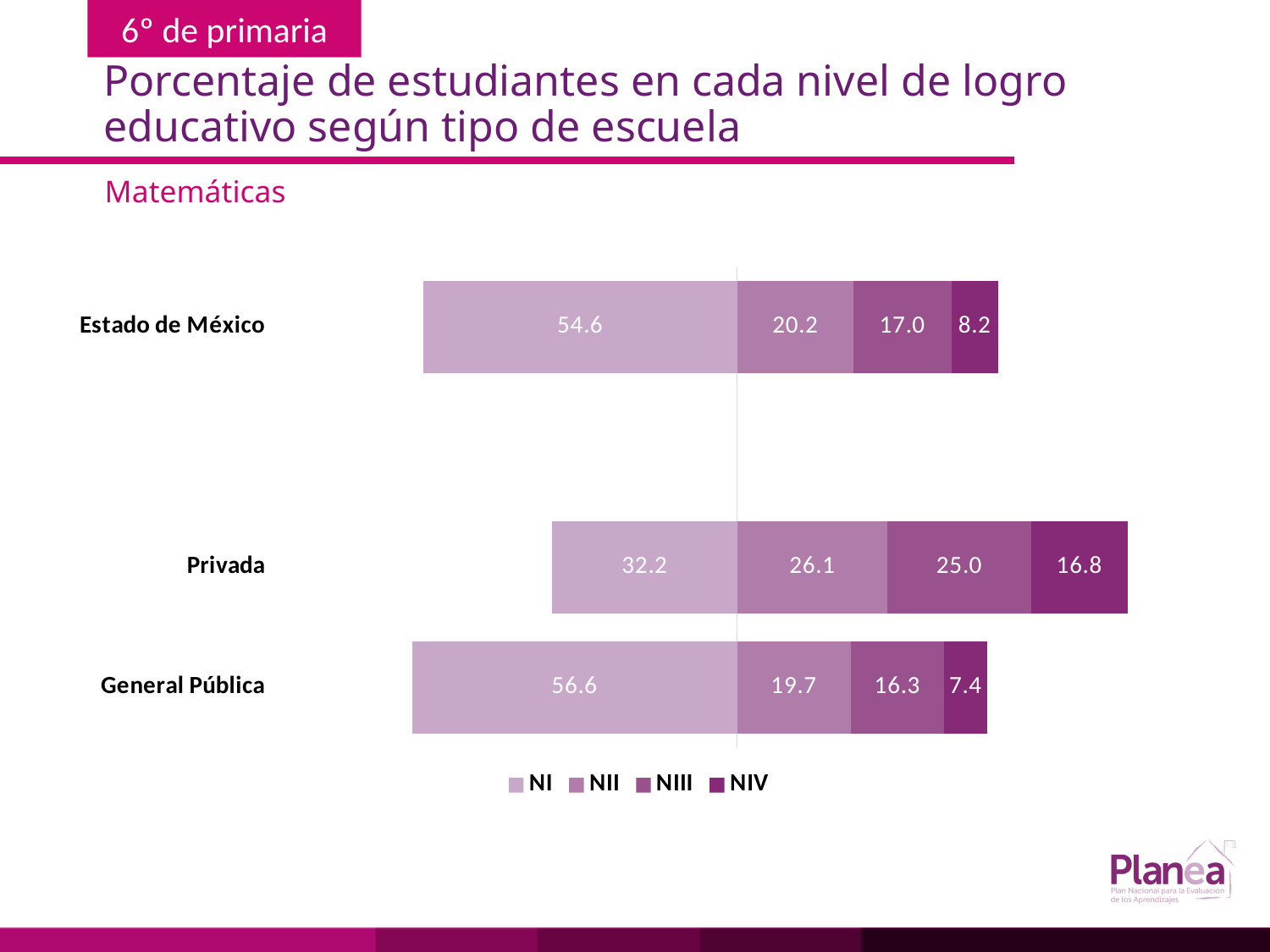
What is the difference between the NI values for General Pública and Privada? 24.4 Which category has the highest NI value? General Pública What is the NIV value for Estado de México? 8.2 What is the NI value for Privada? 32.2 Which is larger, the NII value for Privada or the NII value for Estado de México? Privada Which category has the lowest NIV value? General Pública How many series does the legend list? 4 What kind of chart is shown on the slide? Stacked bar chart What subject is named above the chart? Matemáticas What is the total of the stacked bar for Estado de México? 100.0 How many categories are shown in the chart? 3 What is the NIII value for General Pública? 16.3